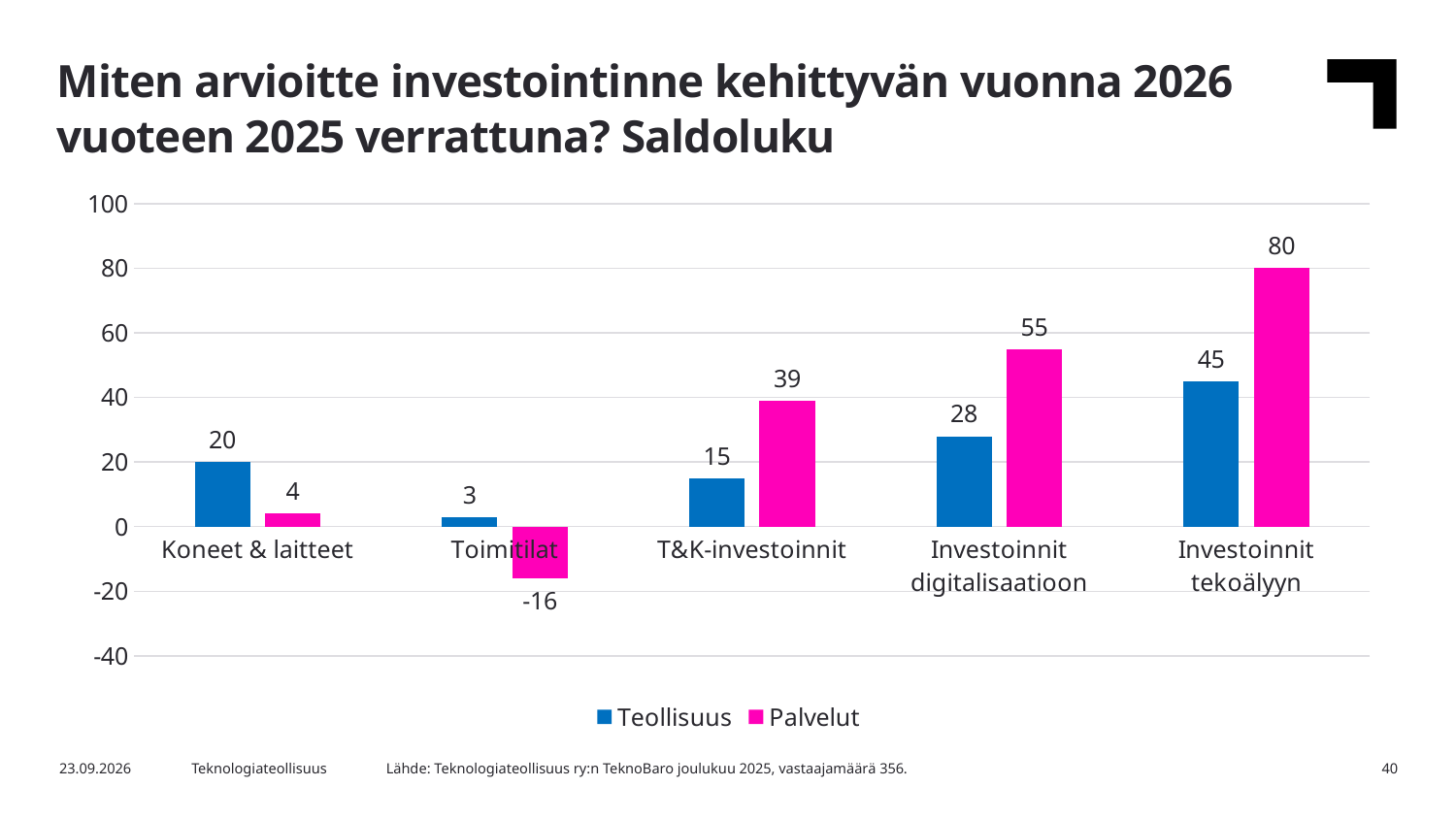
Which category has the lowest Teollisuus value? Toimitilat What is the Palvelut value for Investoinnit tekoälyyn? 80 What kind of chart is shown on the slide? Bar chart What is the Palvelut value for Toimitilat? -16 How many series does the legend list? 2 What is the difference between the Palvelut and Teollisuus values for T&K-investoinnit? 24 Which category has the highest Palvelut value? Investoinnit tekoälyyn For Koneet & laitteet, which series has the larger value, Teollisuus or Palvelut? Teollisuus What is the Teollisuus value for Koneet & laitteet? 20 Which series is shown in magenta in the legend? Palvelut How many categories are shown on the x axis? 5 What is the Teollisuus value for Investoinnit digitalisaatioon? 28